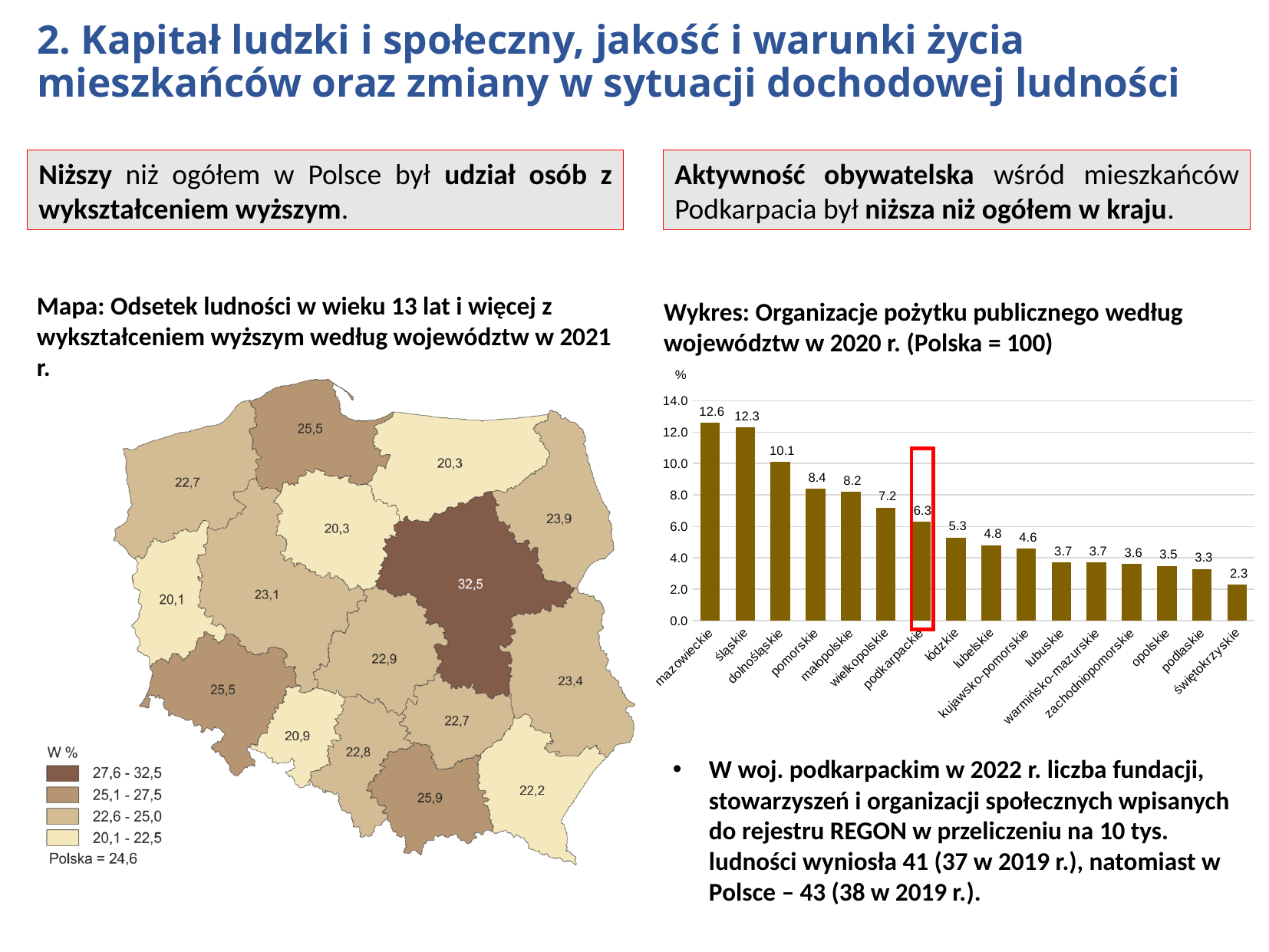
On the bar chart, is the value for wielkopolskie greater or less than 8.0? less What kind of chart is used to show organizacje pożytku publicznego według województw? bar chart How many voivodeships are shown on the bar chart? 16 On the bar chart, which voivodeship has the lowest value? świętokrzyskie On the bar chart, which is larger, the value for łódzkie or the value for lubelskie? łódzkie On the bar chart, what is the difference between the values for mazowieckie and podkarpackie? 6.3 On the bar chart, what is the value for dolnośląskie? 10.1 On the bar chart, what is the value for mazowieckie? 12.6 On the bar chart, do the values rise or fall from left to right along the x axis? fall On the bar chart, what is the difference between the values for pomorskie and małopolskie? 0.2 On the bar chart 'Organizacje pożytku publicznego według województw w 2020 r.', what is the value for podkarpackie? 6.3 On the bar chart, which voivodeship has the highest value? mazowieckie